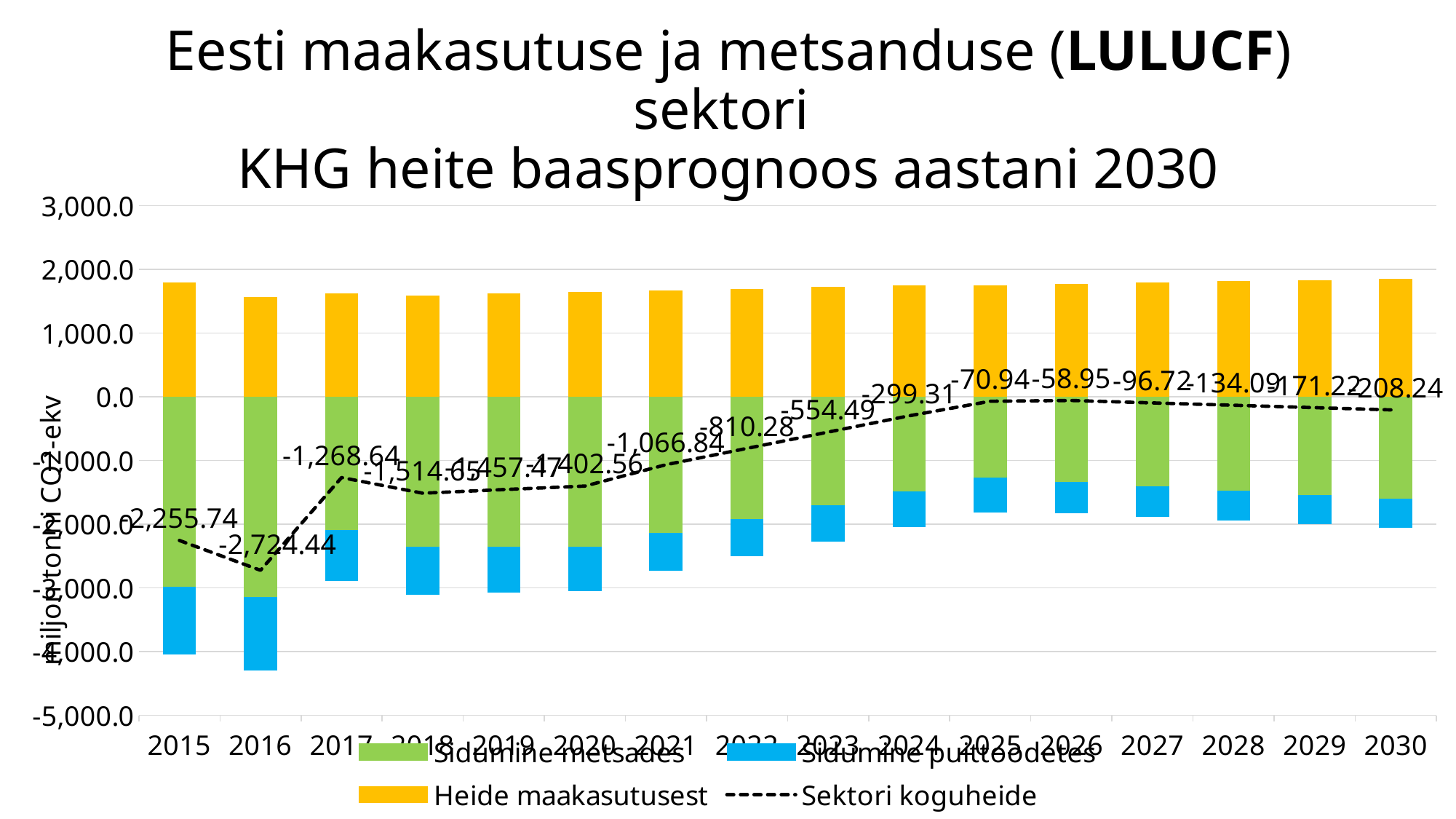
How many series does the legend list? 4 Does Sektori koguheide rise or fall from 2016 to 2026? rise What is the value of Sektori koguheide for 2016? -2,724.44 In which year is Sektori koguheide highest? 2026 Is the value of Heide maakasutusest for 2015 greater or less than 1,000.0? greater What is the difference between the Sektori koguheide values for 2015 and 2016? 468.70 What is the value of Sektori koguheide for 2024? -299.31 How many years are shown on the x axis? 16 What is the value of Sektori koguheide for 2030? -208.24 In which year is Sektori koguheide lowest? 2016 What is the value of Sektori koguheide for 2021? -1,066.84 Which year has the higher Sektori koguheide value, 2022 or 2023? 2023